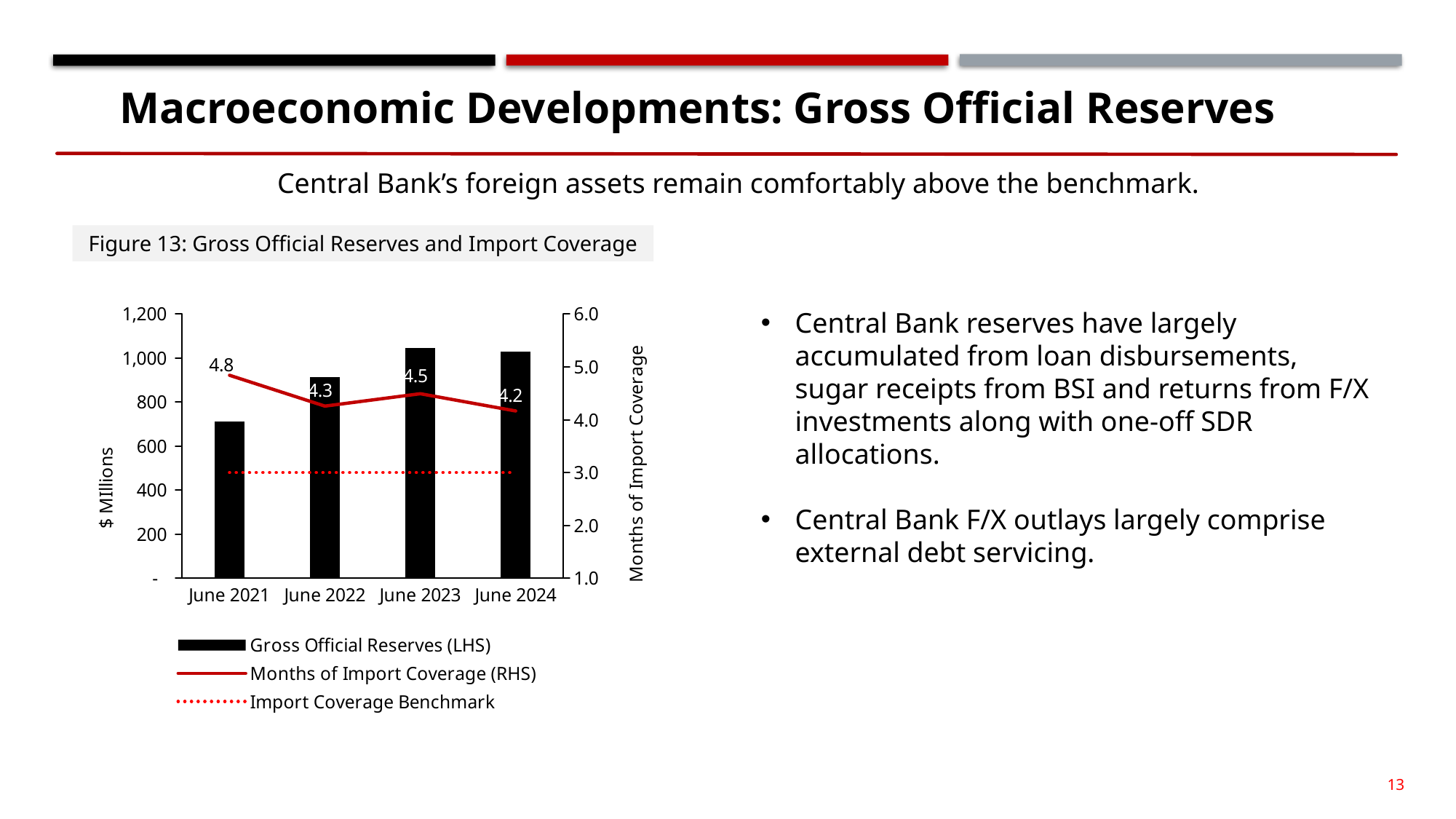
What is the difference in months of import coverage between June 2021 and June 2024? 0.6 How many series does the legend list? 3 Is the value of Gross Official Reserves for June 2021 greater or less than 800? less Which is larger, the months of import coverage in June 2022 or June 2023? June 2023 What is the months of import coverage for June 2022? 4.3 In which period is the months of import coverage lowest? June 2024 What is the months of import coverage for June 2021? 4.8 Which period has the lowest Gross Official Reserves? June 2021 What is the months of import coverage for June 2024? 4.2 How many periods are shown on the x axis? 4 Is the value of Gross Official Reserves for June 2023 greater or less than 1,000? greater In which period is the months of import coverage highest? June 2021